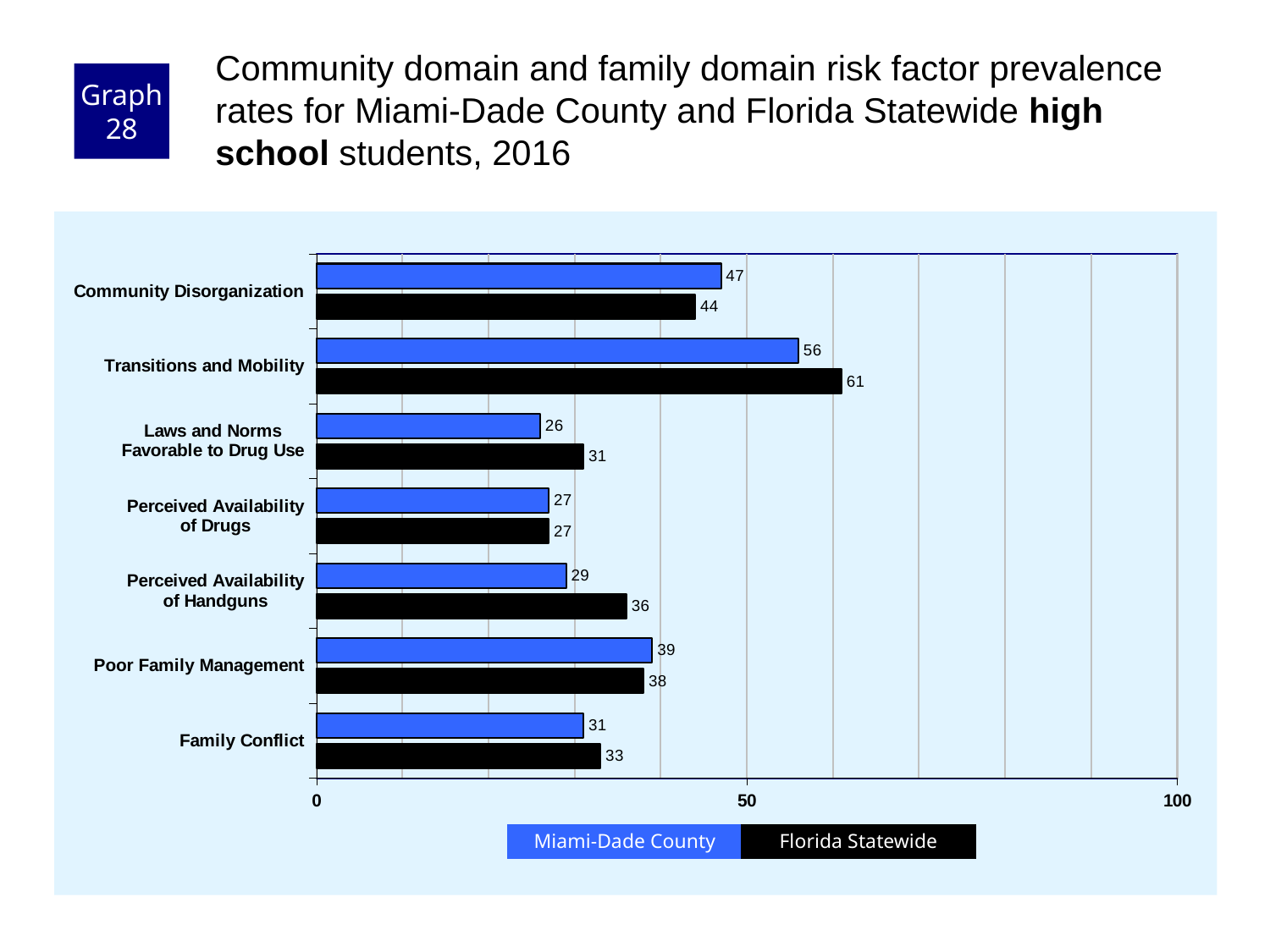
Which risk factor has the lowest Miami-Dade County value? Laws and Norms Favorable to Drug Use How many risk factor categories are shown on the chart? 7 For Poor Family Management, which is larger: the Miami-Dade County value or the Florida Statewide value? Miami-Dade County What kind of chart is shown on the slide? Bar chart What is the Miami-Dade County value for Community Disorganization? 47 What is the Florida Statewide value for Transitions and Mobility? 61 Is the Florida Statewide value for Transitions and Mobility greater or less than 50? greater Which colour represents Florida Statewide in the chart? Black Which risk factor has the highest Florida Statewide value? Transitions and Mobility What is the Miami-Dade County value for Perceived Availability of Handguns? 29 What is the difference between the Florida Statewide and Miami-Dade County values for Perceived Availability of Handguns? 7 How many series does the legend list? 2